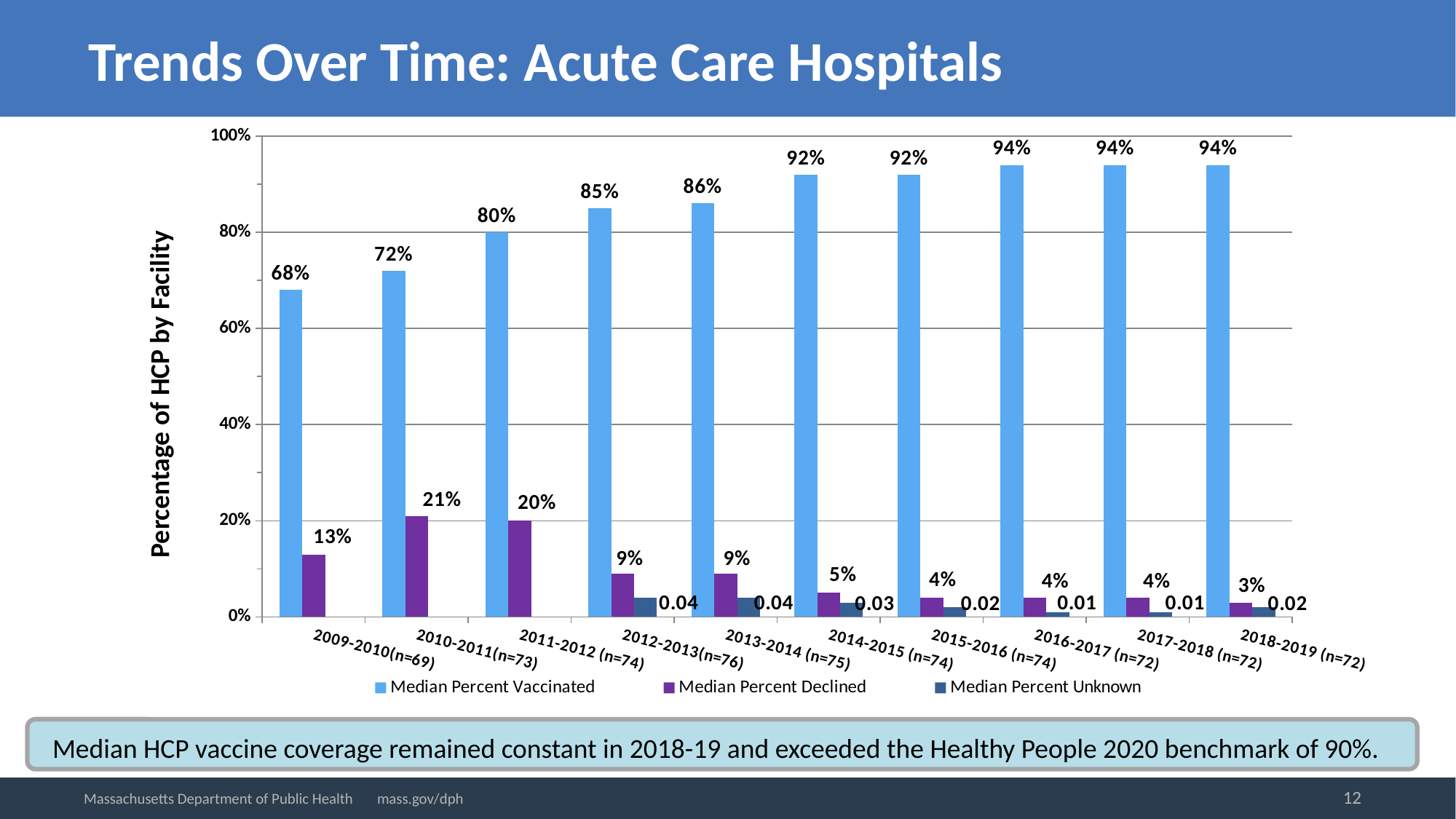
What is the Median Percent Vaccinated for 2011-2012 (n=74)? 80% Does the Median Percent Vaccinated generally rise or fall from 2009-2010 to 2018-2019? Rise Which season has the lowest Median Percent Vaccinated? 2009-2010(n=69) Which is larger: the Median Percent Declined for 2012-2013(n=76) or for 2014-2015 (n=74)? 2012-2013(n=76) What is the title of the vertical axis? Percentage of HCP by Facility How many series does the legend list? 3 What is the Median Percent Declined for 2010-2011(n=73)? 21% By how many percentage points does the Median Percent Vaccinated for 2018-2019 (n=72) exceed that for 2009-2010(n=69)? 26 percentage points How many seasons are shown on the x axis? 10 What kind of chart is shown on the slide? Bar chart What is the Median Percent Unknown value shown for 2014-2015 (n=74)? 0.03 Which season has the highest Median Percent Declined? 2010-2011(n=73)